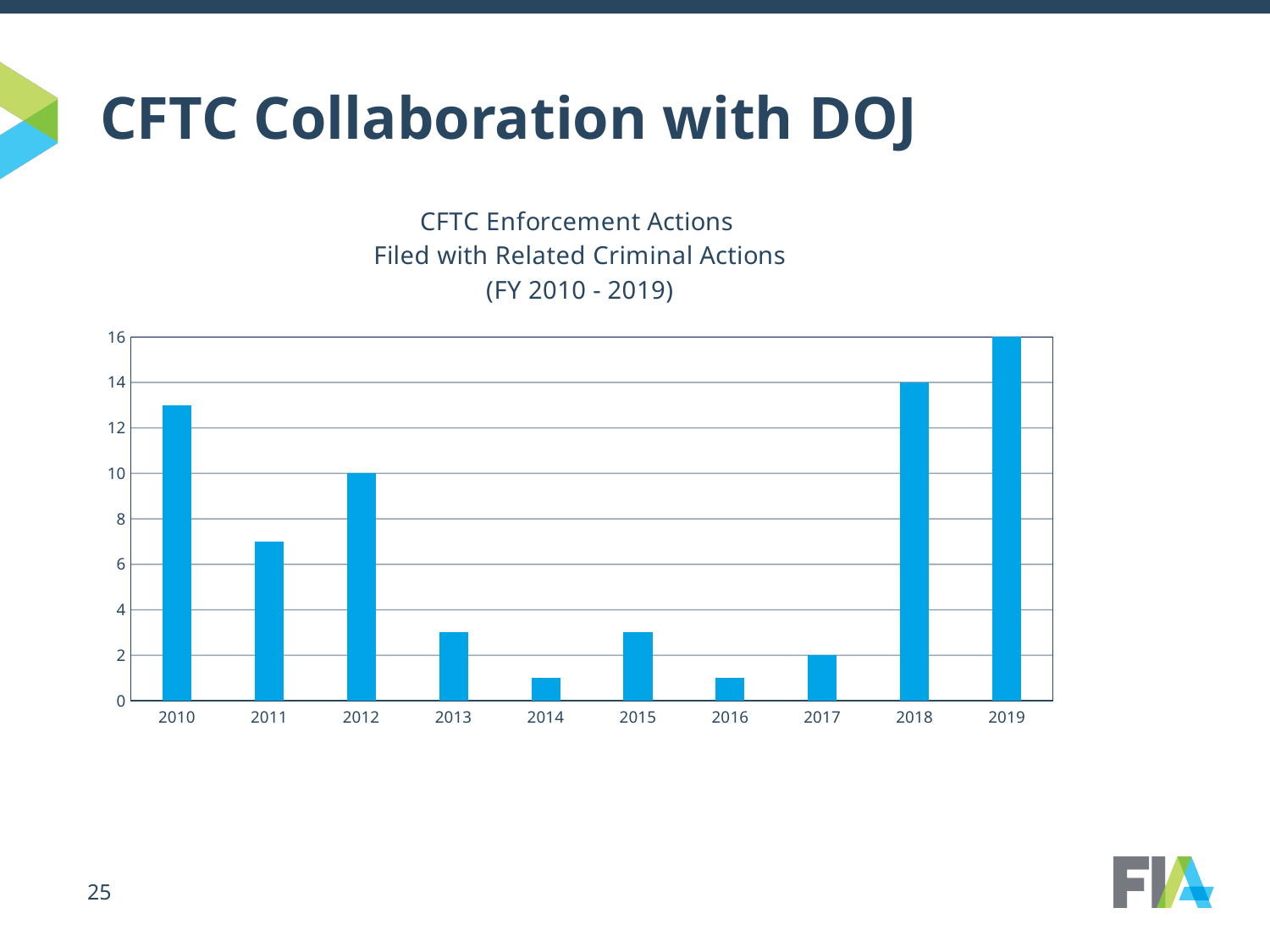
Which year has the larger value, 2010 or 2011? 2010 What kind of chart is shown on the slide? bar chart Is the value for 2010 greater or less than 12? greater What is the value for 2017? 2 Is the value for 2011 greater or less than 8? less What is the value for 2012? 10 What is the value for 2019? 16 What is the title of the chart? CFTC Enforcement Actions Filed with Related Criminal Actions (FY 2010 - 2019) What is the difference between the values for 2019 and 2018? 2 How many years are shown on the x axis of the chart? 10 What is the value for 2018? 14 Which year has the highest number of CFTC enforcement actions filed with related criminal actions? 2019